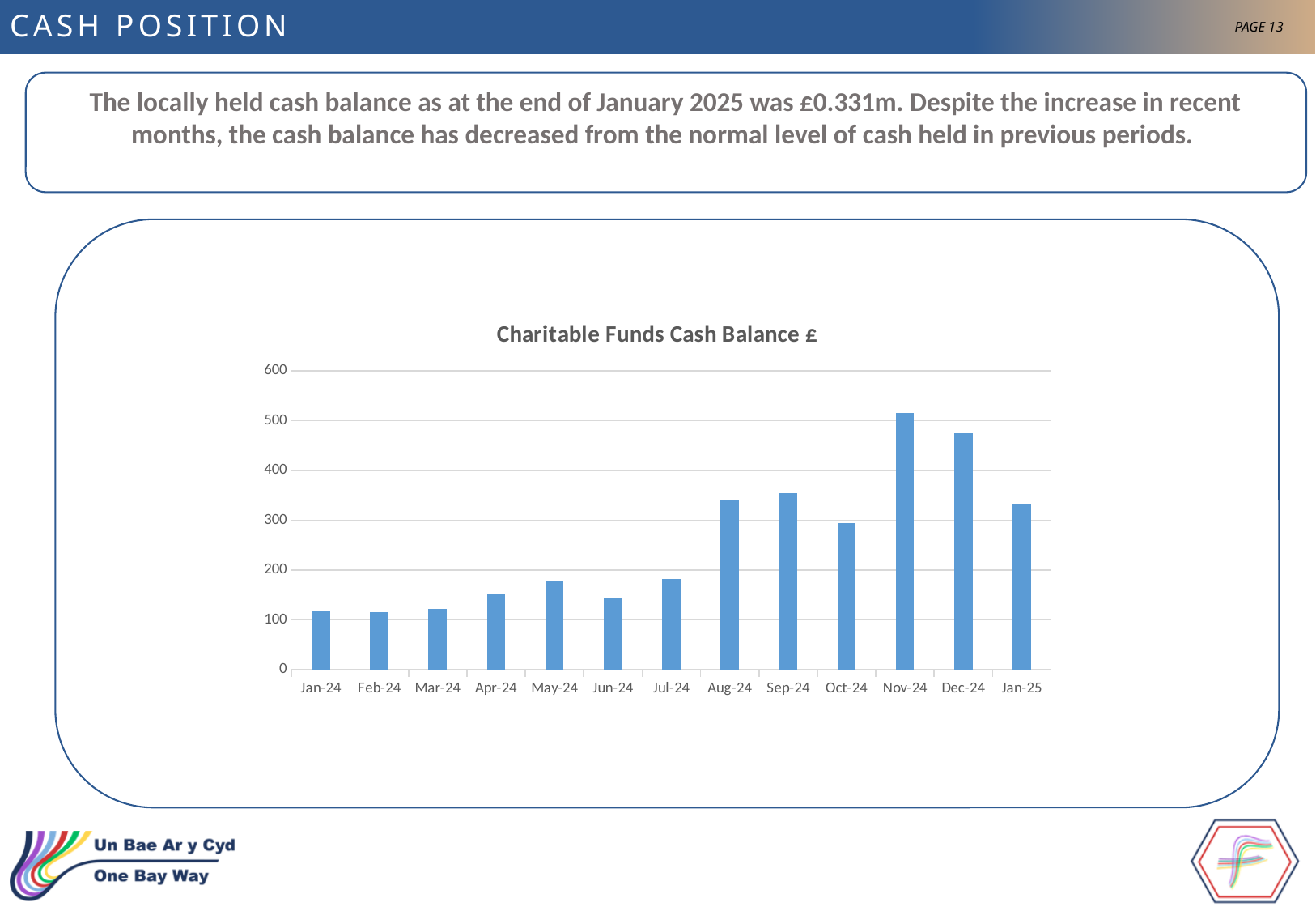
Overall, do the values rise or fall from Jan-24 to Jan-25? Rise Is the value for Jan-25 greater or less than 300? greater Is the value for Apr-24 greater or less than 100? greater What is the title of the chart? Charitable Funds Cash Balance £ Is the value for May-24 greater or less than 200? less How many months are plotted on the chart? 13 Which is larger, the value for Nov-24 or Dec-24? Nov-24 Which is larger, the value for Aug-24 or Oct-24? Aug-24 What type of chart is shown on the slide? Bar chart Which month has the highest cash balance? Nov-24